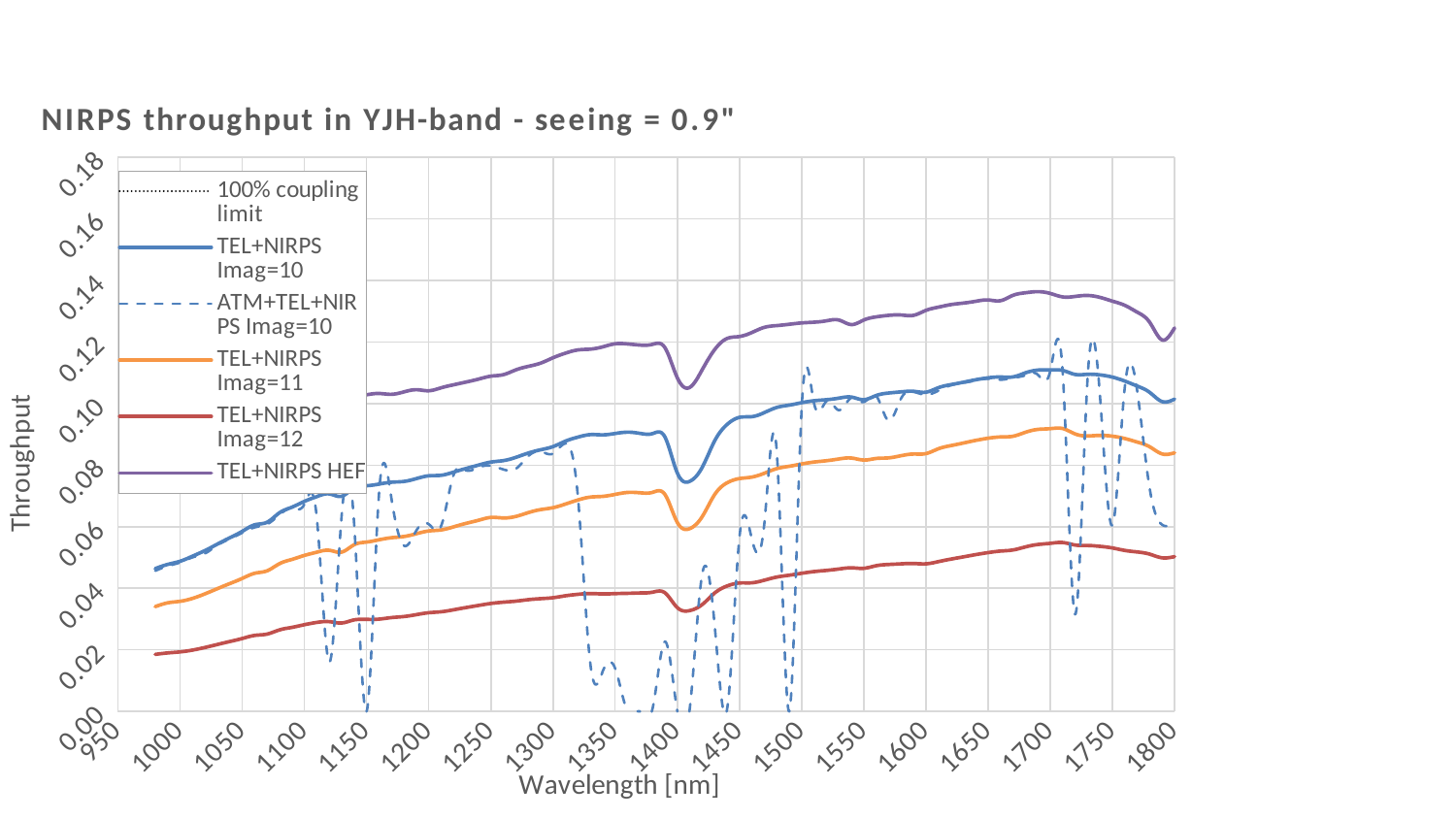
Which solid series has the lowest throughput across the wavelength range? TEL+NIRPS Imag=12 Is the value of TEL+NIRPS HEF at 1000 nm greater or less than 0.10? greater What is the label of the x axis? Wavelength [nm] Does the TEL+NIRPS Imag=12 throughput generally rise or fall from 1000 nm to 1700 nm? rise Which series has the highest throughput across the wavelength range? TEL+NIRPS HEF Is the value of TEL+NIRPS Imag=10 at 1000 nm greater or less than 0.06? less How many series does the legend list? 6 Is the value of TEL+NIRPS Imag=11 at 1700 nm greater or less than 0.08? greater At 1600 nm, which is larger: TEL+NIRPS HEF or TEL+NIRPS Imag=12? TEL+NIRPS HEF What is the title of the chart? NIRPS throughput in YJH-band - seeing = 0.9" What kind of chart is shown on the slide? line chart